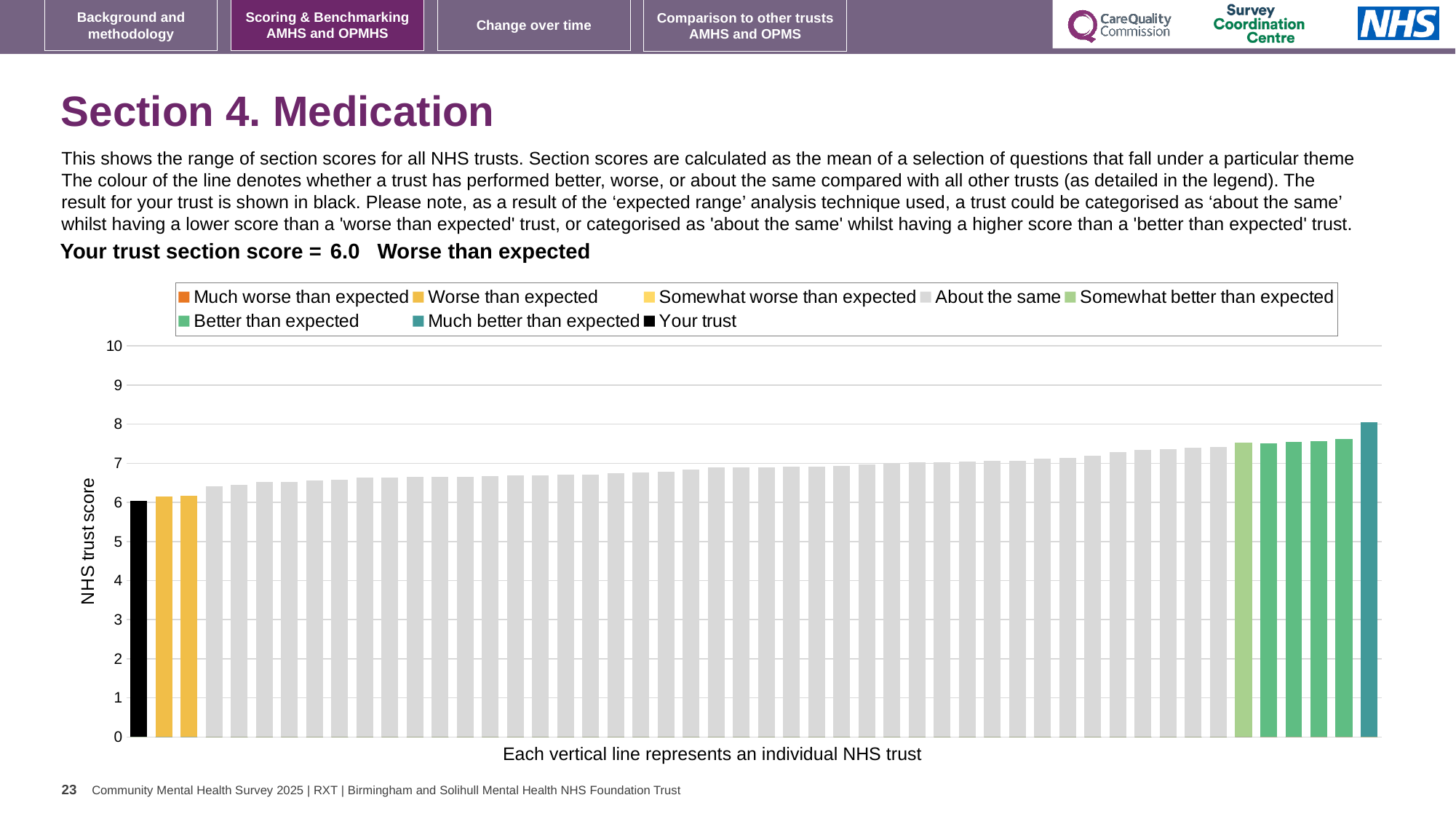
Which category is your trust placed in for this section? Worse than expected Which legend category does the shortest bar belong to? Your trust Do the bar values rise or fall from left to right along the x axis? rise What kind of chart is shown on the slide? bar chart What is the section score for your trust? 6.0 Is the value of the tallest bar greater or less than 7? greater Is the value for your trust greater or less than 7? less How many bars are coloured as 'Better than expected'? 4 How many entries does the chart legend list? 8 Is the value for your trust greater or less than 5? greater Which legend category does the tallest bar belong to? Much better than expected How many bars are coloured as 'Worse than expected'? 2